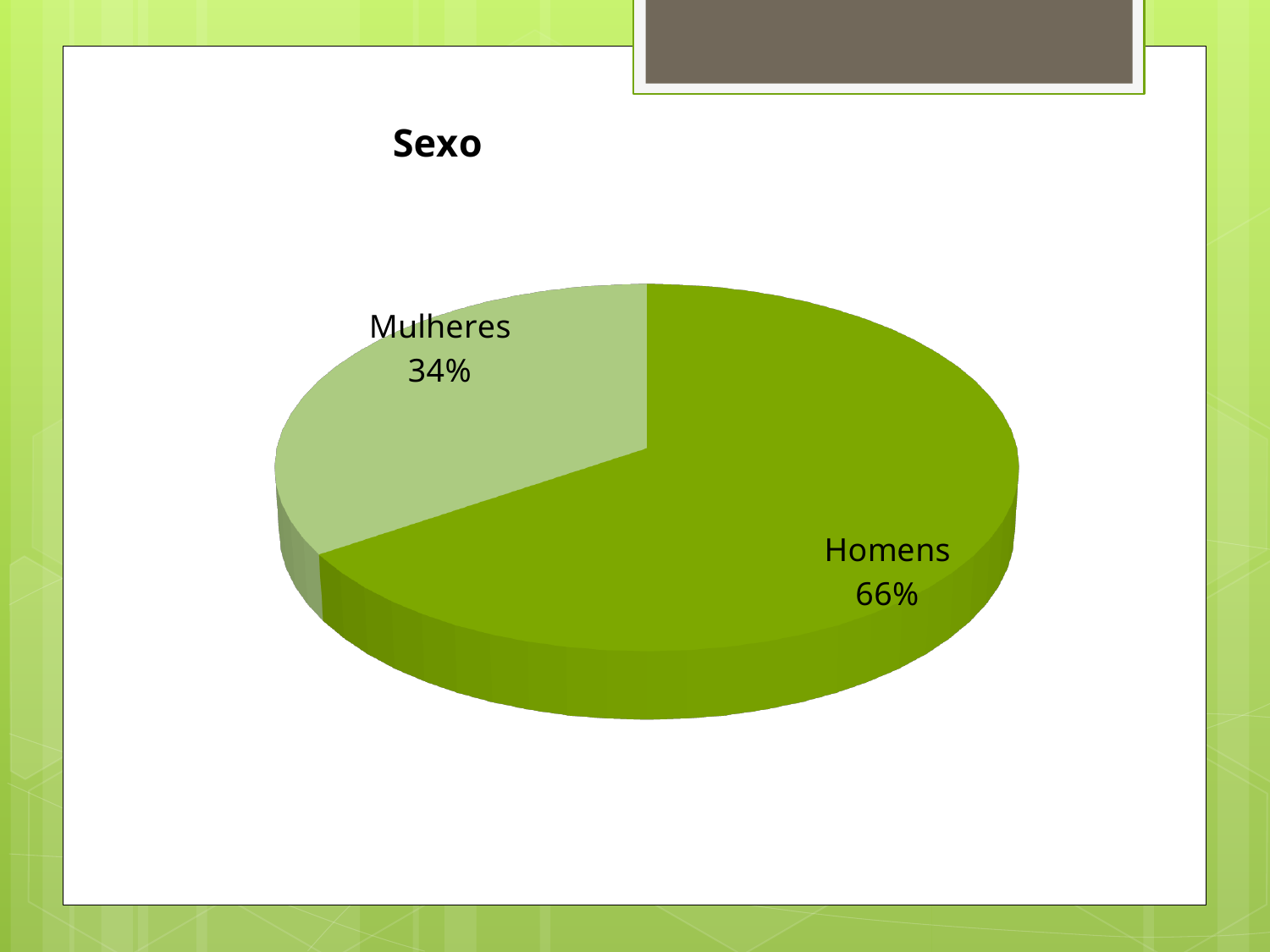
Is the share for Homens greater or less than 50%? greater Which is larger, the share for Homens or the share for Mulheres? Homens What kind of chart is shown on the slide? pie chart What is the difference in percentage points between Homens and Mulheres? 32 Which category has the largest slice of the pie? Homens Is the share for Mulheres greater or less than 50%? less What share of the pie does Homens represent? 66% What share of the pie does Mulheres represent? 34% Which slice is shown in the lighter green colour? Mulheres What is the title of the chart? Sexo Which category has the smallest slice of the pie? Mulheres How many categories are shown in the pie chart? 2